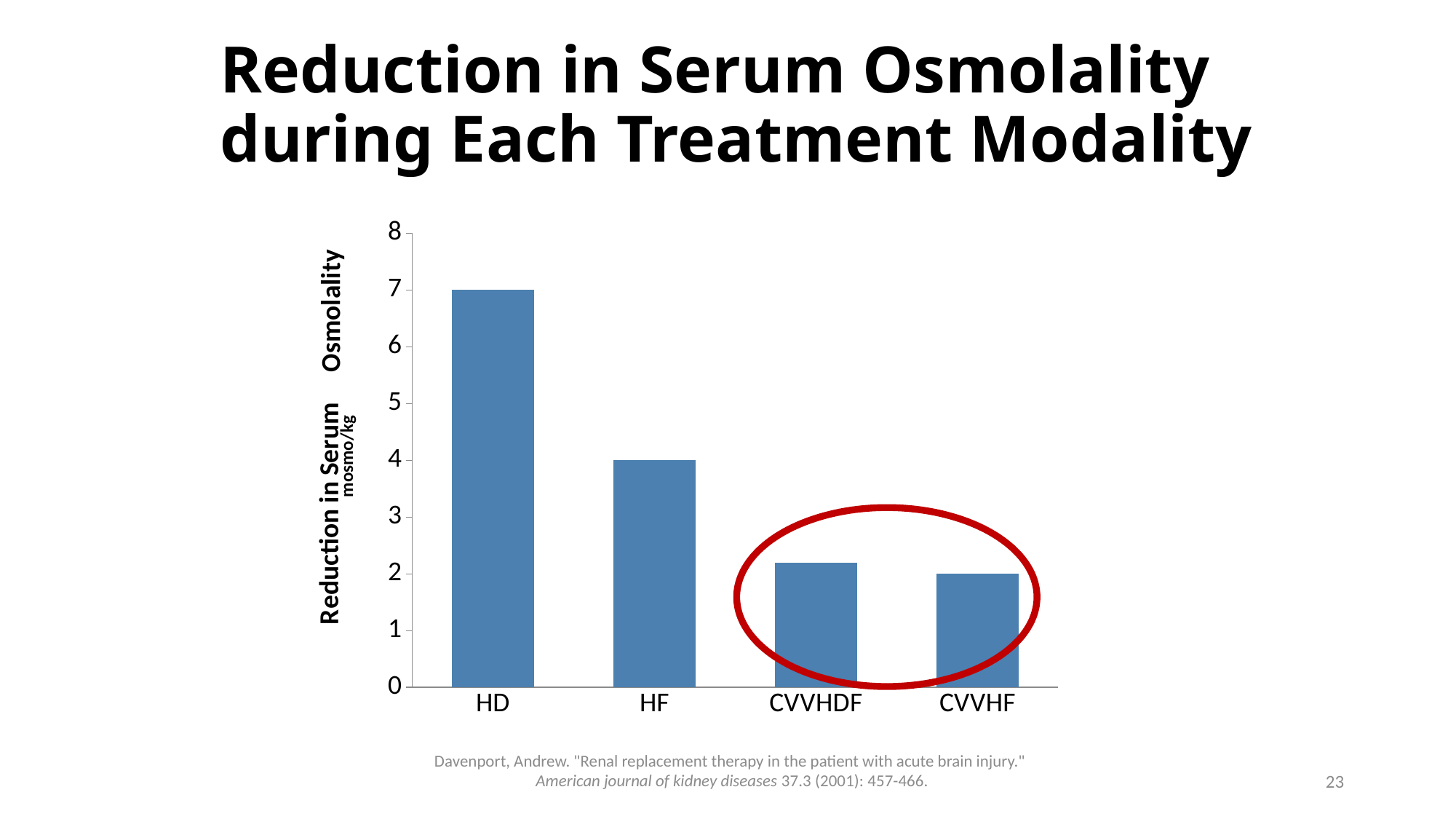
What is the reduction in serum osmolality for CVVHF? 2 Do the values rise or fall from HD to CVVHF along the x axis? fall Which treatment modality has the highest reduction in serum osmolality? HD What is the reduction in serum osmolality for HF? 4 Which two bars are circled in red on the chart? CVVHDF and CVVHF What type of chart is shown on the slide? bar chart What is the difference between the reduction in serum osmolality for HD and for HF? 3 Is the value for CVVHDF greater or less than 3? less Is the value for HD greater or less than 6? greater What is the reduction in serum osmolality for HD? 7 How many treatment modalities are shown on the x axis of the chart? 4 Which has a larger reduction in serum osmolality, HF or CVVHDF? HF